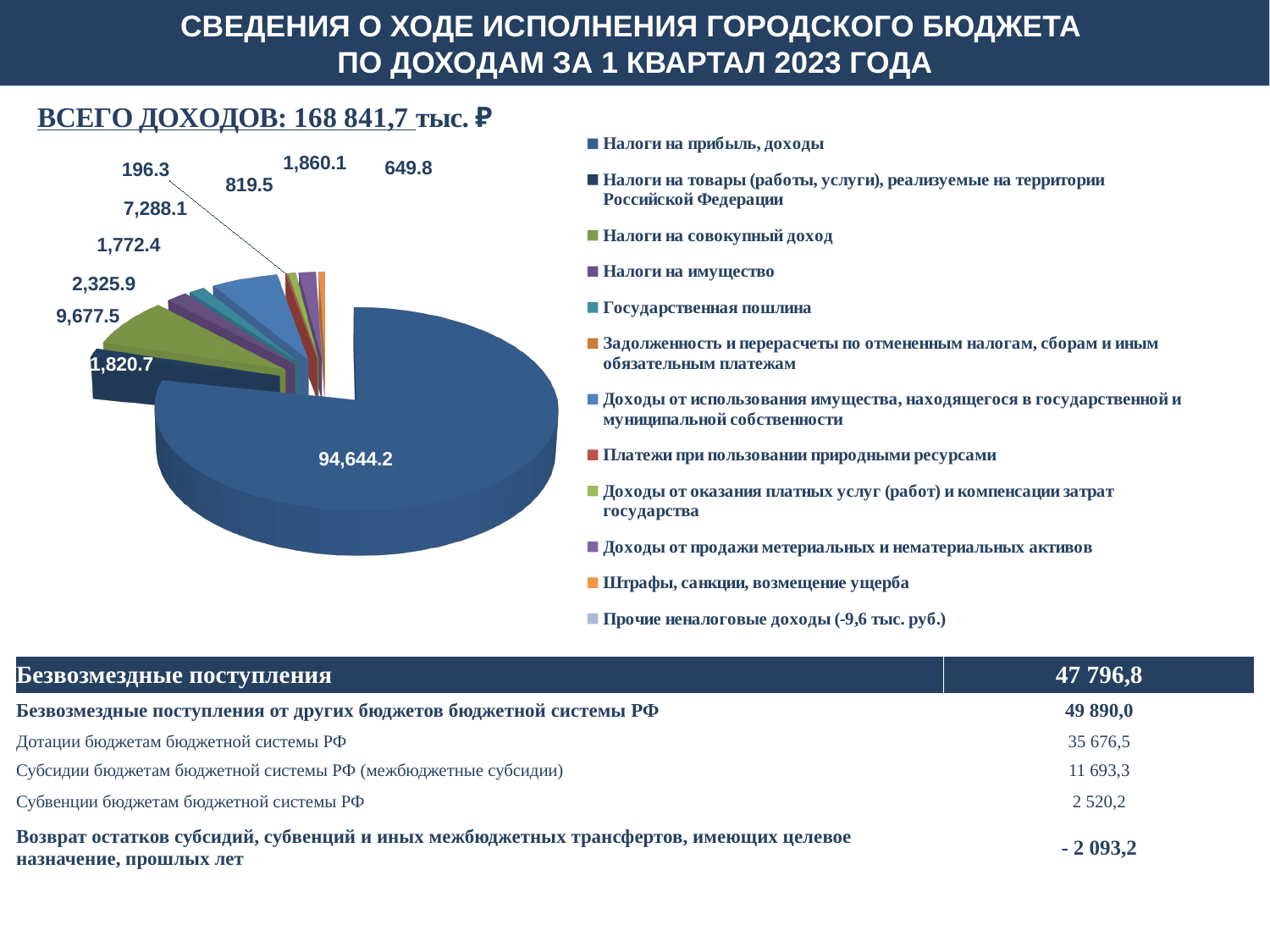
Which category has the largest slice in the pie chart? Налоги на прибыль, доходы What is the difference between the slices labelled 2,325.9 and 1,772.4? 553.5 What total income (ВСЕГО ДОХОДОВ) is stated above the pie chart? 168 841,7 тыс. ₽ What is the smallest value labelled on the pie chart? 196.3 How many data labels are printed on the pie chart? 10 What is the value shown on the largest slice of the pie chart? 94,644.2 What kind of chart is shown on the slide? pie chart How many entries does the legend of the pie chart list? 12 Which is larger on the pie chart: the slice labelled 9,677.5 or the slice labelled 7,288.1? 9,677.5 What is the value of the slice for Налоги на совокупный доход? 9,677.5 Which legend entry of the pie chart shows a negative value in its label? Прочие неналоговые доходы (-9,6 тыс. руб.) What is the difference between the largest slice (94,644.2) and the slice for Налоги на совокупный доход (9,677.5)? 84,966.7